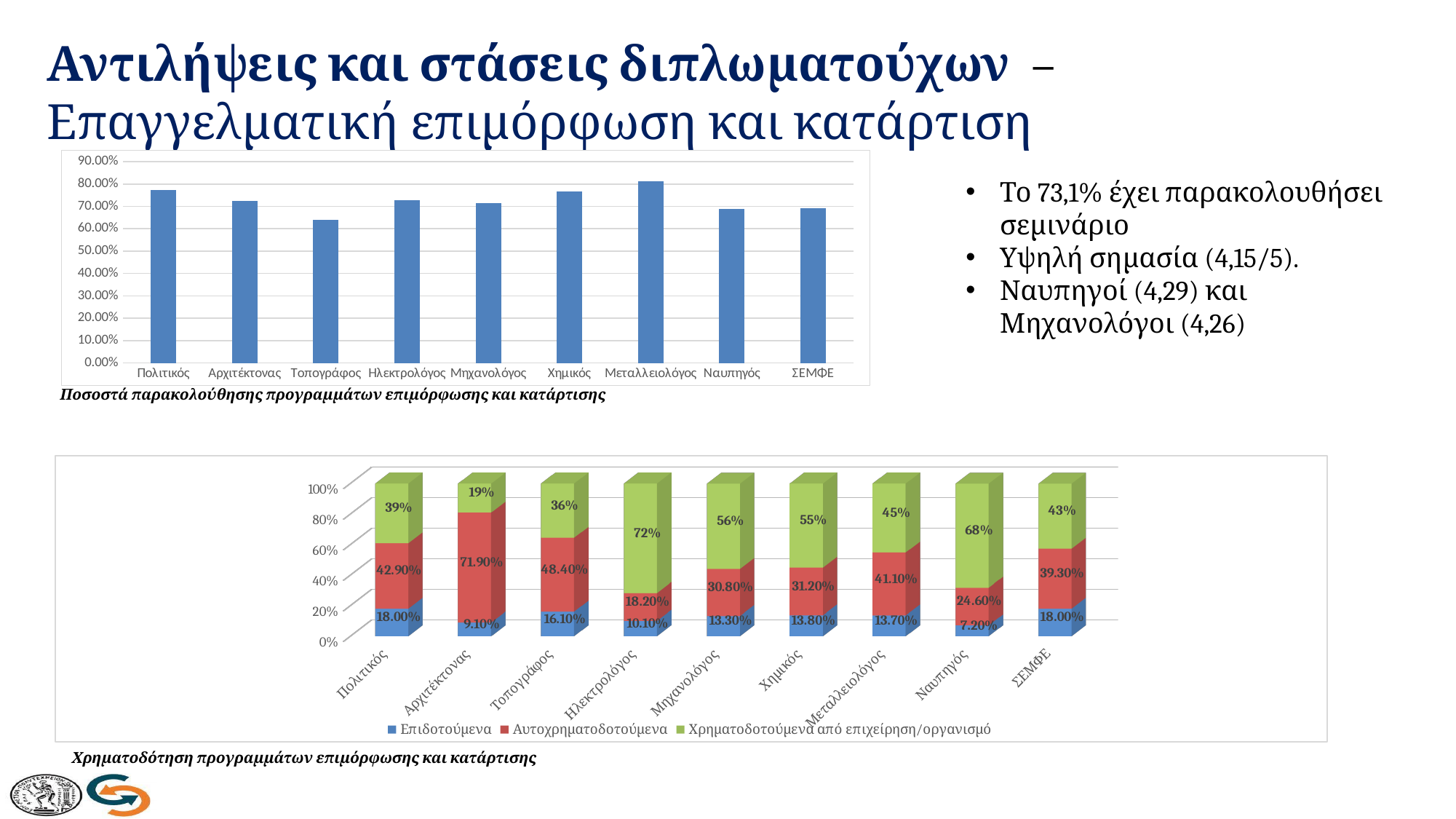
In the bottom chart (Χρηματοδότηση προγραμμάτων επιμόρφωσης και κατάρτισης), which category has the highest Χρηματοδοτούμενα από επιχείρηση/οργανισμό share? Ηλεκτρολόγος In the top chart (Ποσοστά παρακολούθησης προγραμμάτων επιμόρφωσης και κατάρτισης), is the value for Τοπογράφος greater or less than 70.00%? less In the bottom chart (Χρηματοδότηση προγραμμάτων επιμόρφωσης και κατάρτισης), which category has the lowest Επιδοτούμενα value? Ναυπηγός In the top chart (Ποσοστά παρακολούθησης προγραμμάτων επιμόρφωσης και κατάρτισης), which category has the highest bar? Μεταλλειολόγος In the top chart (Ποσοστά παρακολούθησης προγραμμάτων επιμόρφωσης και κατάρτισης), how many categories are shown on the x axis? 9 What kind of chart is the bottom chart (Χρηματοδότηση προγραμμάτων επιμόρφωσης και κατάρτισης)? Stacked bar chart In the bottom chart (Χρηματοδότηση προγραμμάτων επιμόρφωσης και κατάρτισης), what is the Αυτοχρηματοδοτούμενα value for Αρχιτέκτονας? 71.90% In the top chart (Ποσοστά παρακολούθησης προγραμμάτων επιμόρφωσης και κατάρτισης), which category has the lowest bar? Τοπογράφος In the bottom chart (Χρηματοδότηση προγραμμάτων επιμόρφωσης και κατάρτισης), what is the Επιδοτούμενα value for Ναυπηγός? 7.20% How many series does the legend of the bottom chart (Χρηματοδότηση προγραμμάτων επιμόρφωσης και κατάρτισης) list? 3 In the top chart (Ποσοστά παρακολούθησης προγραμμάτων επιμόρφωσης και κατάρτισης), is the value for Πολιτικός greater or less than 70.00%? greater In the bottom chart (Χρηματοδότηση προγραμμάτων επιμόρφωσης και κατάρτισης), what is the difference between the Αυτοχρηματοδοτούμενα and Επιδοτούμενα values for Πολιτικός? 24.90%